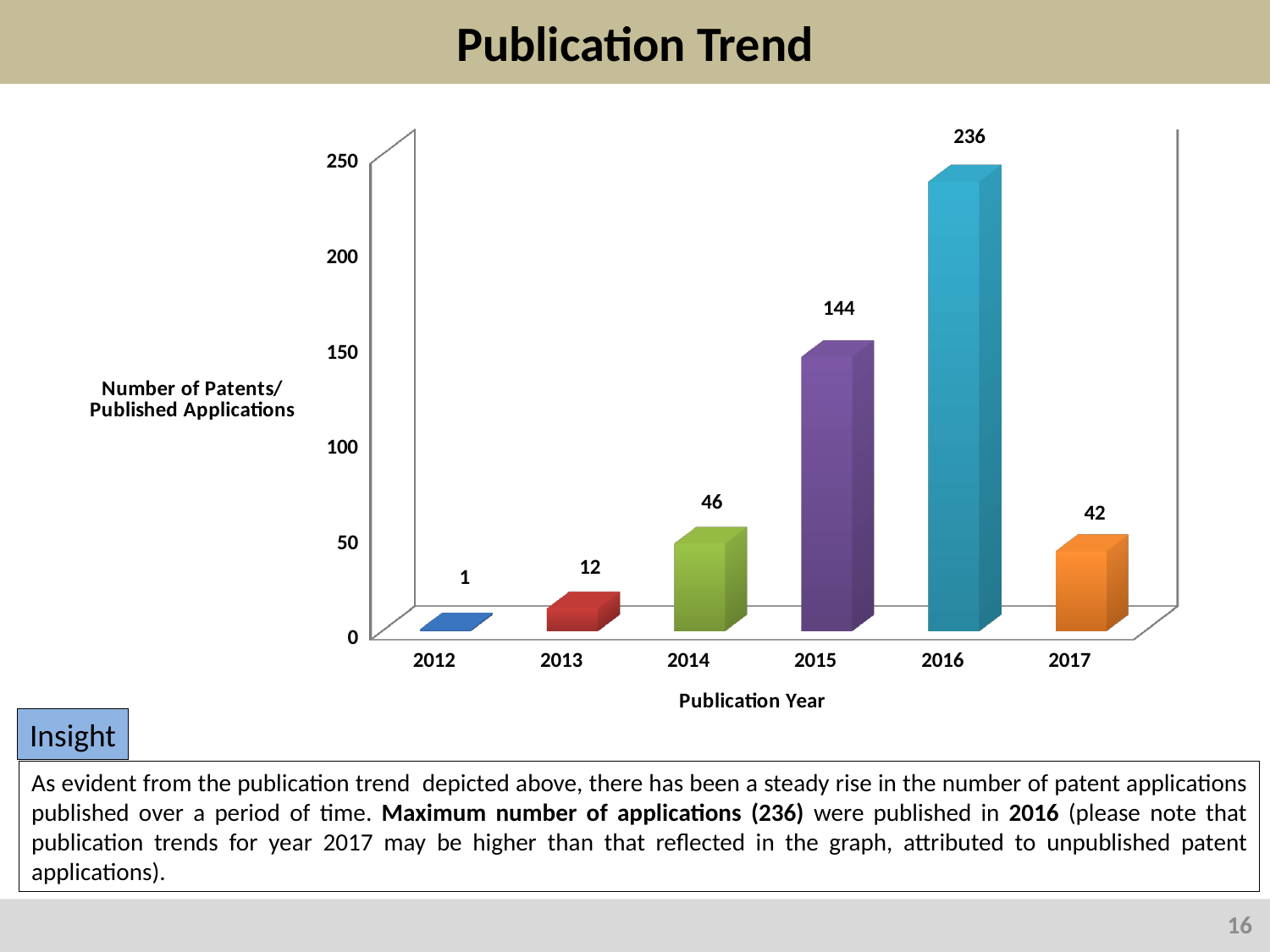
What is the label of the x axis? Publication Year Which publication year has the lowest number of patents/published applications? 2012 What is the difference between the values for 2016 and 2015? 92 Which year has a larger value, 2014 or 2017? 2014 Which publication year has the highest number of patents/published applications? 2016 What is the number of patents/published applications for 2017? 42 What kind of chart is shown on the slide? bar chart What is the number of patents/published applications for 2015? 144 Is the value for 2016 greater or less than 200? greater How many publication years are shown on the x axis? 6 What is the difference between the values for 2014 and 2017? 4 What is the number of patents/published applications for 2013? 12